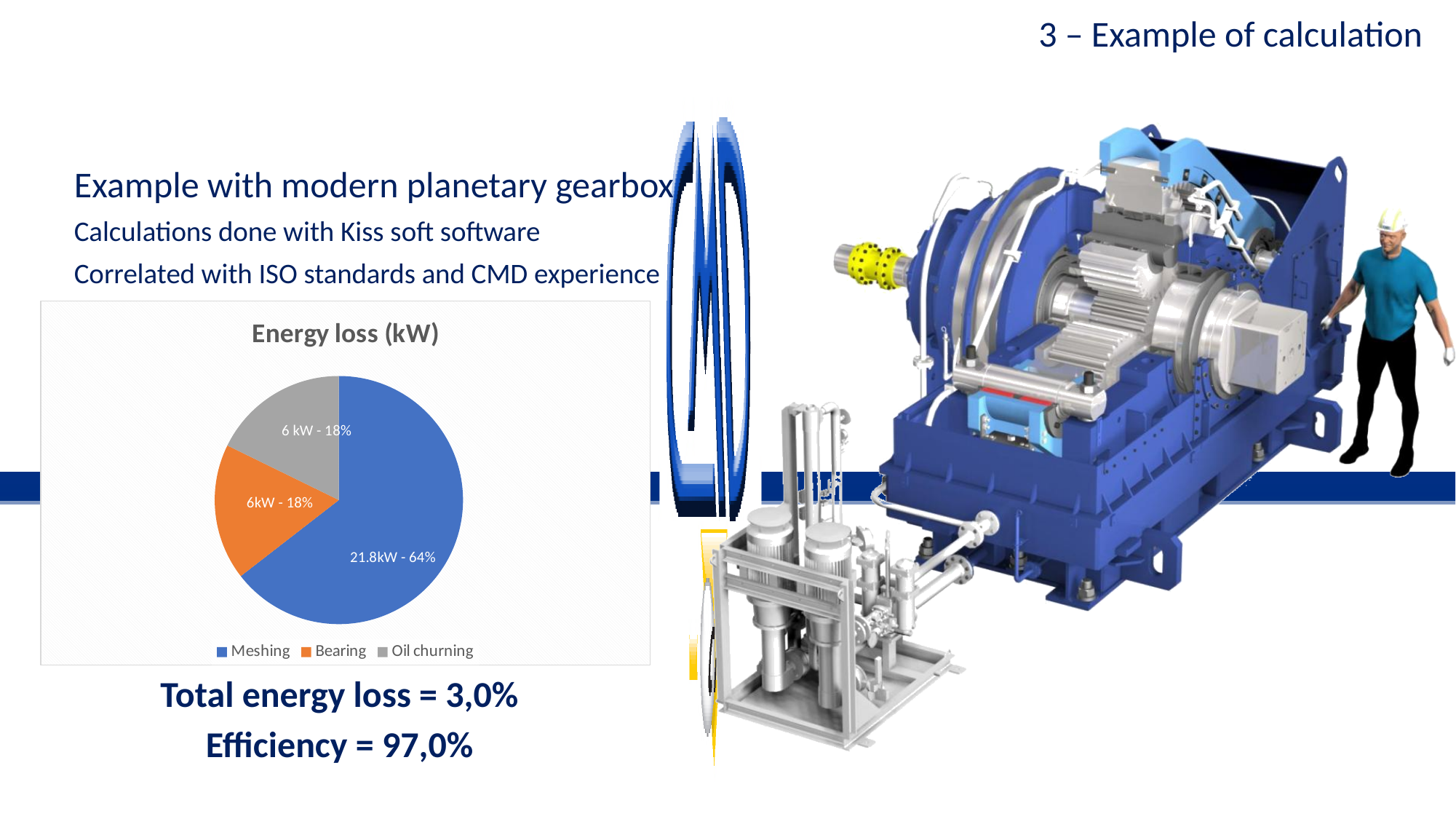
What is the data label shown for the Oil churning slice? 6 kW - 18% What is the title of the chart? Energy loss (kW) What is the data label shown for the Bearing slice? 6kW - 18% How many slices does the pie chart have? 3 What is the difference in kW between the Meshing loss and the Bearing loss? 15.8 kW Which category accounts for the largest share of energy loss? Meshing What share of the pie does the Bearing slice represent? 18% What share of the pie does the Meshing slice represent? 64% What is the data label shown for the Meshing slice? 21.8kW - 64% Which is larger, the energy loss for Meshing or for Bearing? Meshing What kind of chart is shown on the slide? Pie chart How many entries does the chart legend list? 3